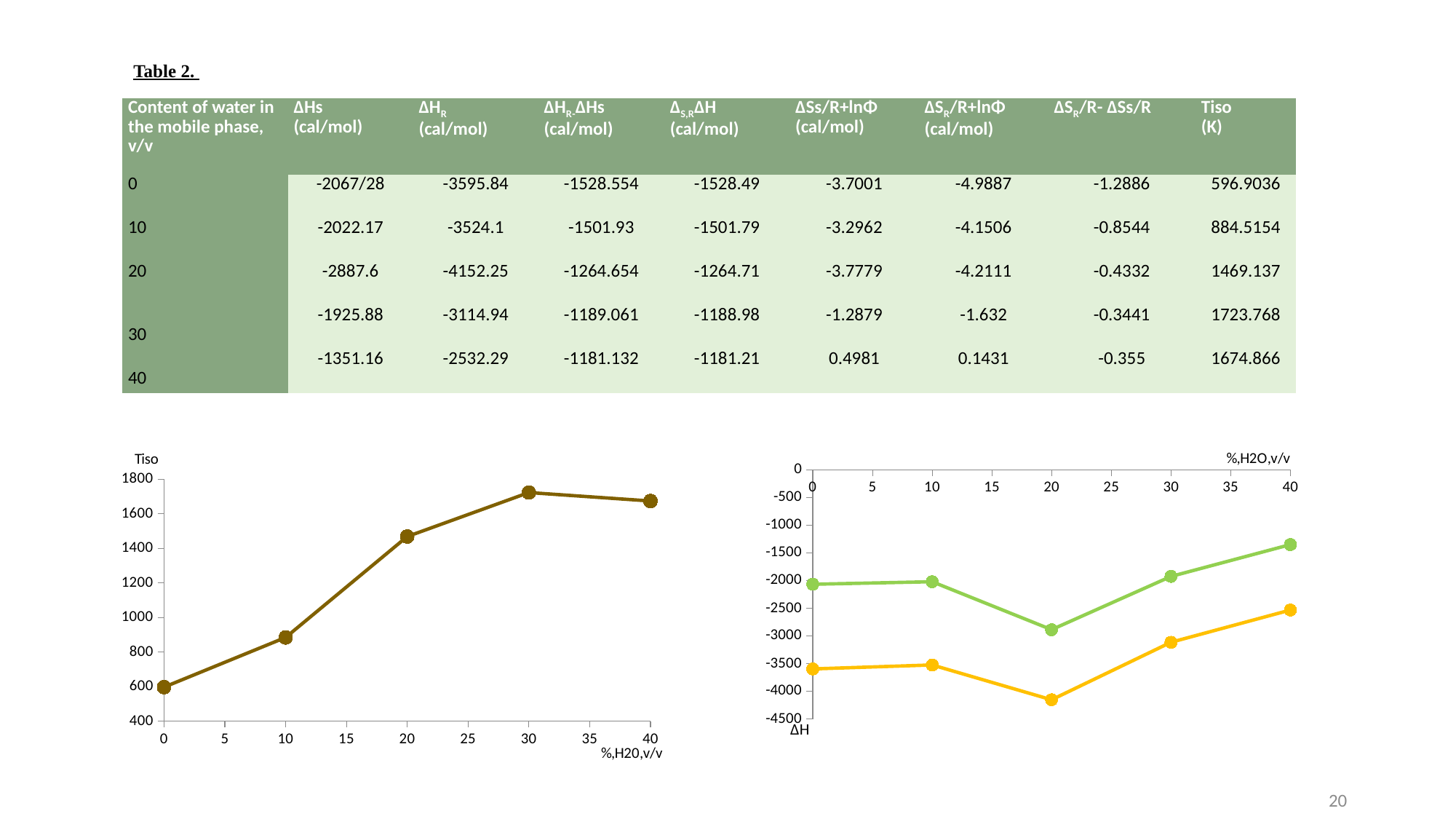
On the left chart (Tiso), which has the larger Tiso value: 20 or 30 %,H2O,v/v? 30 On the left chart (Tiso), is the value at 10 %,H2O,v/v greater or less than 1000? less On the left chart (Tiso), how many data points are plotted? 5 On the left chart (Tiso), is the value at 20 %,H2O,v/v greater or less than 1400? greater On the right chart (ΔH), which series has the higher values throughout, the green or the yellow? green On the right chart (ΔH), is the yellow series value at 20 %,H2O,v/v greater or less than -4000? less On the left chart (Tiso), at which %,H2O,v/v value is Tiso lowest? 0 On the right chart (ΔH), at which %,H2O,v/v value does the green series reach its lowest point? 20 On the left chart (Tiso), at which %,H2O,v/v value is Tiso highest? 30 On the left chart (Tiso), do the values rise or fall from 0 to 30 %,H2O,v/v? rise On the right chart (ΔH), how many series are plotted? 2 What kind of chart is the left chart (Tiso vs %,H2O,v/v)? line chart